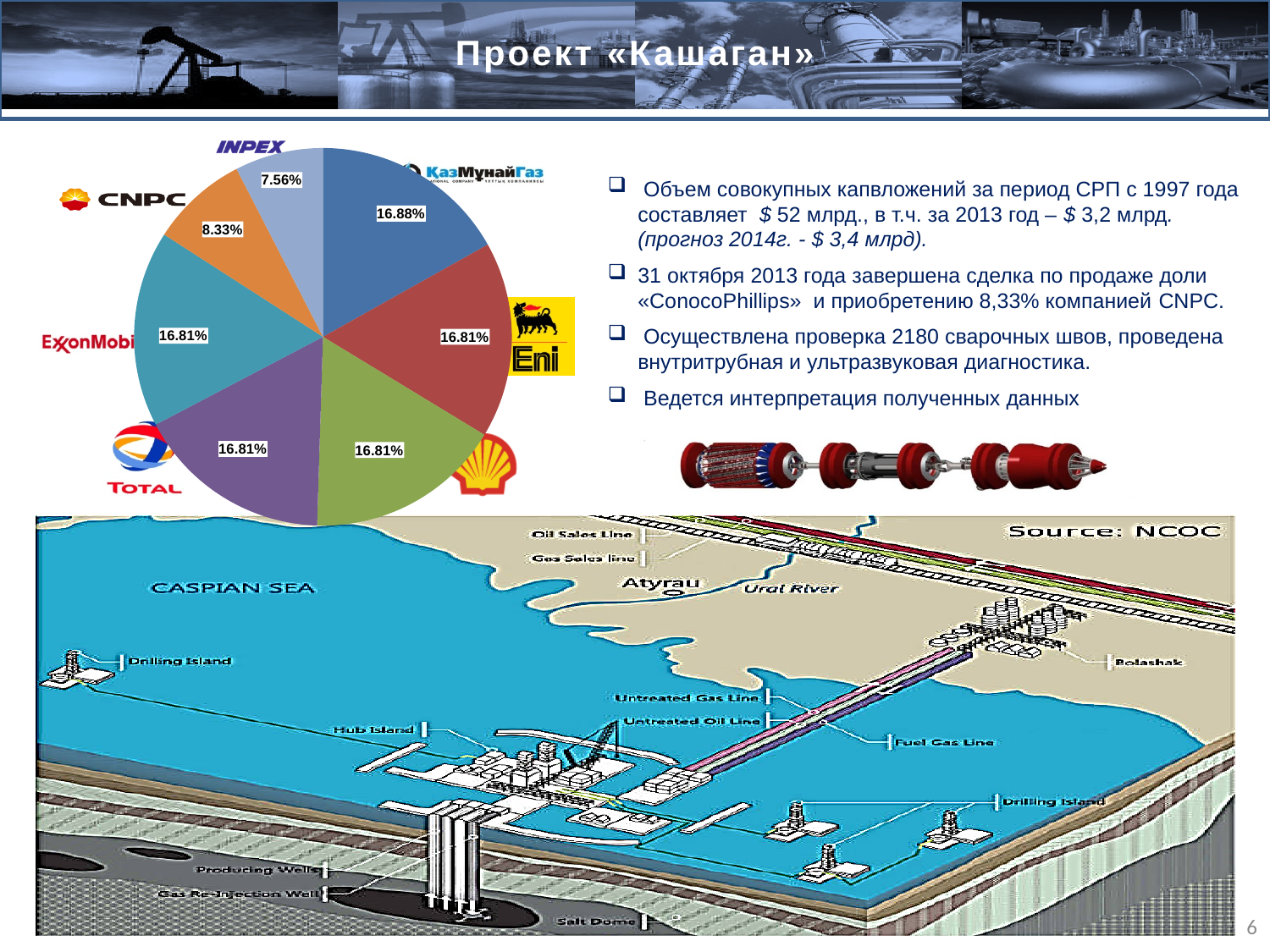
What share of the pie chart belongs to CNPC? 8.33% What share of the pie chart belongs to ExxonMobil? 16.81% Which has the larger share in the pie chart, CNPC or INPEX? CNPC Which company has the largest share in the pie chart? КазМунайГаз (KazMunayGas) What is the difference between the shares of КазМунайГаз (KazMunayGas) and Total in the pie chart? 0.07% What share of the pie chart belongs to КазМунайГаз (KazMunayGas)? 16.88% What share of the pie chart belongs to Eni? 16.81% What share of the pie chart belongs to INPEX? 7.56% Which company has the smallest share in the pie chart? INPEX What is the difference between the shares of CNPC and INPEX in the pie chart? 0.77% How many slices does the pie chart have? 7 What type of chart is shown on the slide? pie chart